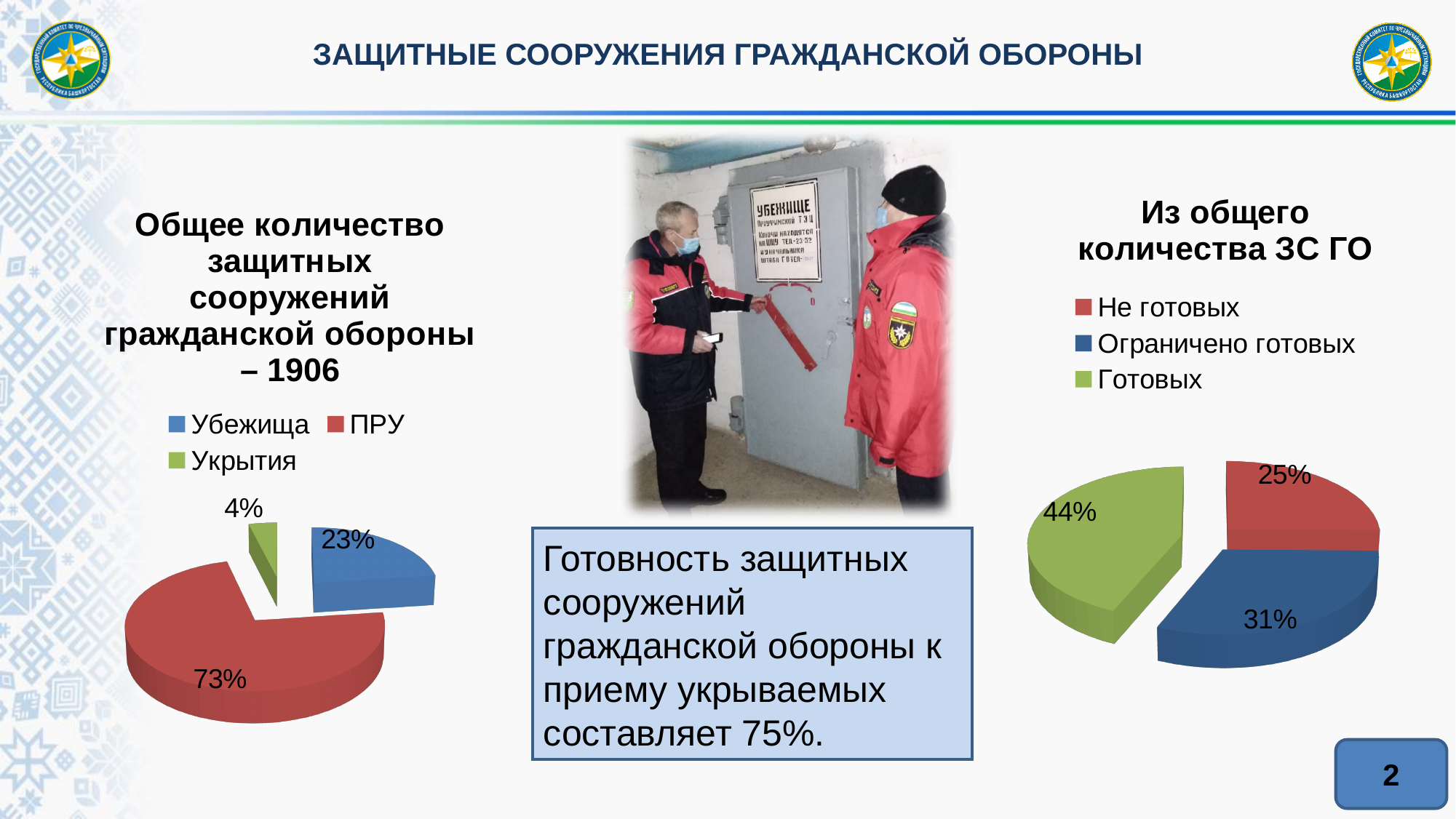
In the right pie chart (Из общего количества ЗС ГО), what share is labelled for Готовых? 44% In the right pie chart (Из общего количества ЗС ГО), which category has the largest slice? Готовых In the right pie chart (Из общего количества ЗС ГО), what share is labelled for Не готовых? 25% In the left pie chart (Общее количество защитных сооружений гражданской обороны – 1906), what is the difference in percentage points between ПРУ and Убежища? 50 In the left pie chart (Общее количество защитных сооружений гражданской обороны – 1906), what share is labelled for ПРУ? 73% In the left pie chart (Общее количество защитных сооружений гражданской обороны – 1906), what share is labelled for Укрытия? 4% In the right pie chart (Из общего количества ЗС ГО), what share is labelled for Ограничено готовых? 31% In the left pie chart (Общее количество защитных сооружений гражданской обороны – 1906), what share is labelled for Убежища? 23% In the right pie chart (Из общего количества ЗС ГО), which is larger: Ограничено готовых or Не готовых? Ограничено готовых How many charts are on the slide, and what type are they? Two pie charts In the left pie chart (Общее количество защитных сооружений гражданской обороны – 1906), which category has the largest slice? ПРУ In the left pie chart (Общее количество защитных сооружений гражданской обороны – 1906), which category has the smallest slice? Укрытия